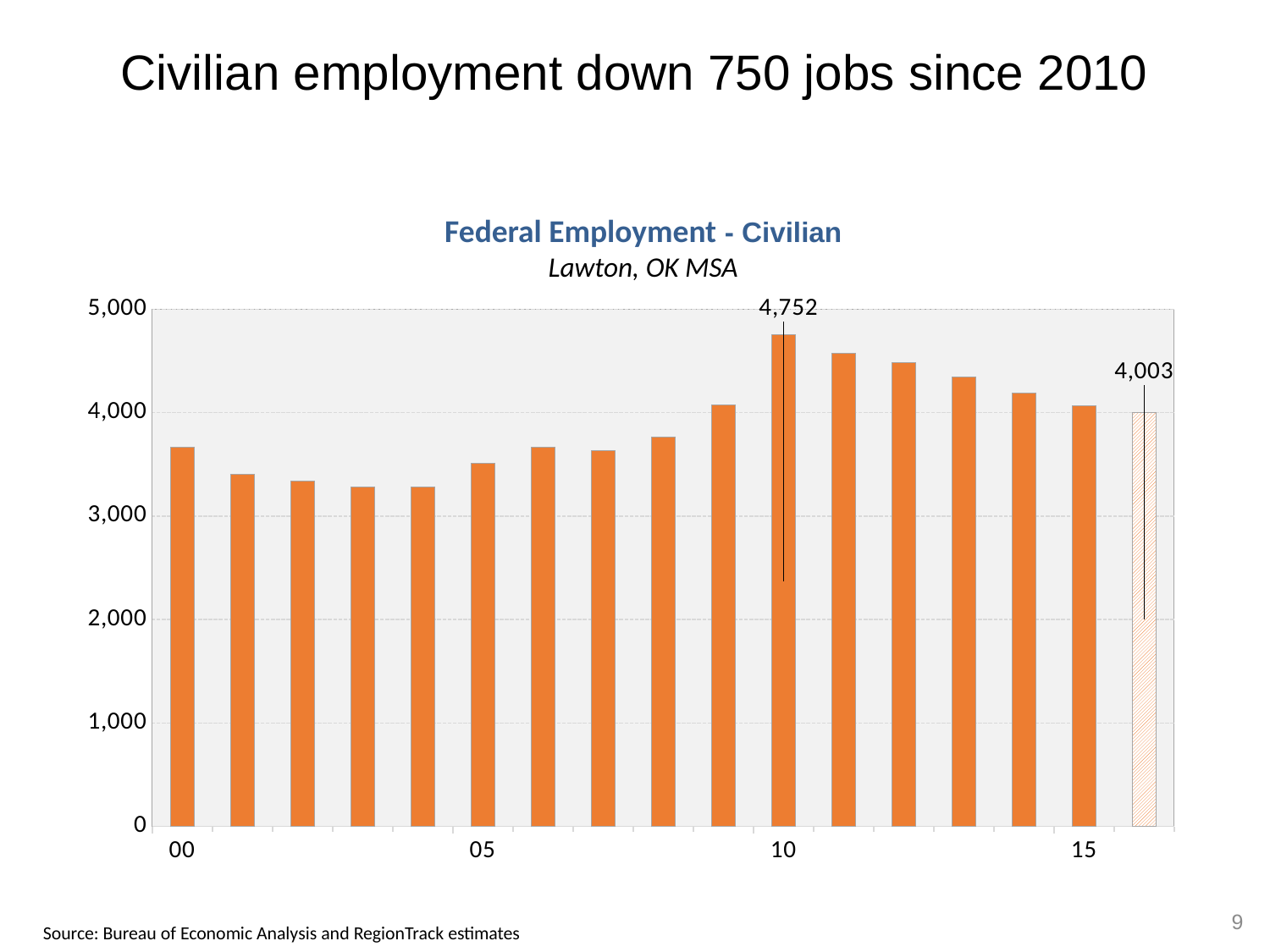
What is the value of the final hatched bar (16) in the Federal Employment - Civilian chart? 4,003 What is the title of the chart? Federal Employment - Civilian Is the value for 11 greater or less than 4,000? greater What is the value of the bar for 10 in the Federal Employment - Civilian chart? 4,752 How many bars are plotted in the chart? 17 Is the value for 03 greater or less than 3,500? less Do the values rise or fall from 10 to 15? fall Which year has the highest federal civilian employment in the chart? 10 Which is larger, the value for 10 or the value for the final hatched bar? 10 What kind of chart is shown on the slide? bar chart Is the value for 00 greater or less than 4,000? less What is the difference between the labeled values for 10 and the final hatched bar? 749